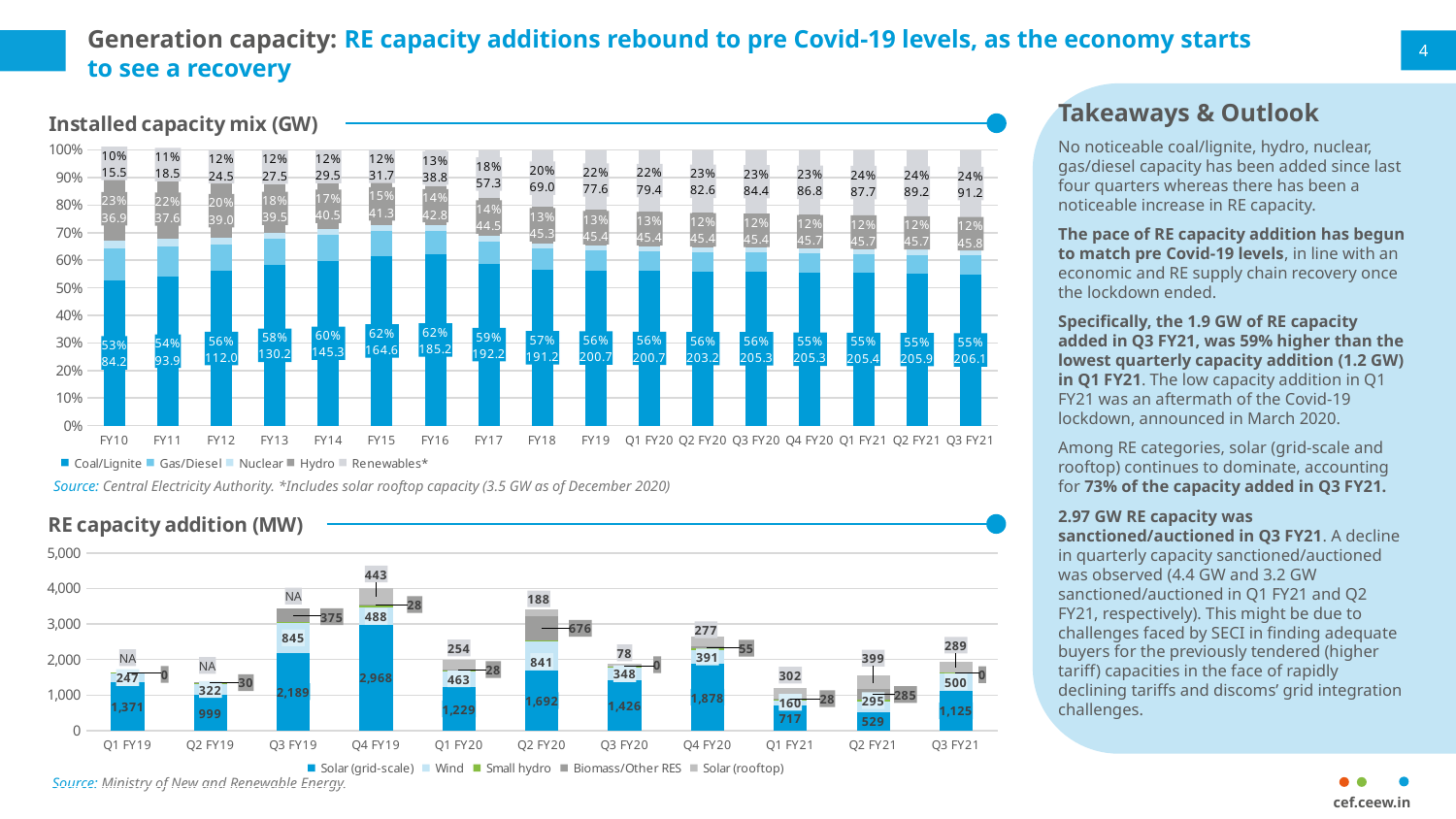
How many quarters are shown on the x axis of the 'RE capacity addition (MW)' chart? 11 In the 'RE capacity addition (MW)' chart, which quarter has the lowest Solar (grid-scale) addition? Q2 FY21 In the 'Installed capacity mix (GW)' chart, what is the Renewables value for Q3 FY21? 91.2 In the 'Installed capacity mix (GW)' chart, what is the Coal/Lignite value for FY10? 84.2 In the 'RE capacity addition (MW)' chart, which quarter has the highest Solar (grid-scale) addition? Q4 FY19 How many series does the legend of the 'Installed capacity mix (GW)' chart list? 5 In the 'RE capacity addition (MW)' chart, what is the Wind addition in Q1 FY21? 160 In the 'Installed capacity mix (GW)' chart, what percentage share does Coal/Lignite have in Q3 FY21? 55% What kind of chart is the 'Installed capacity mix (GW)' chart? Stacked bar chart In the 'RE capacity addition (MW)' chart, what is the difference between the Solar (grid-scale) additions in Q4 FY19 and Q1 FY21? 2,251 In the 'Installed capacity mix (GW)' chart, by how much did the Renewables value increase from FY10 to Q3 FY21? 75.7 In the 'Installed capacity mix (GW)' chart, do the Renewables values rise or fall from FY10 to Q3 FY21? Rise